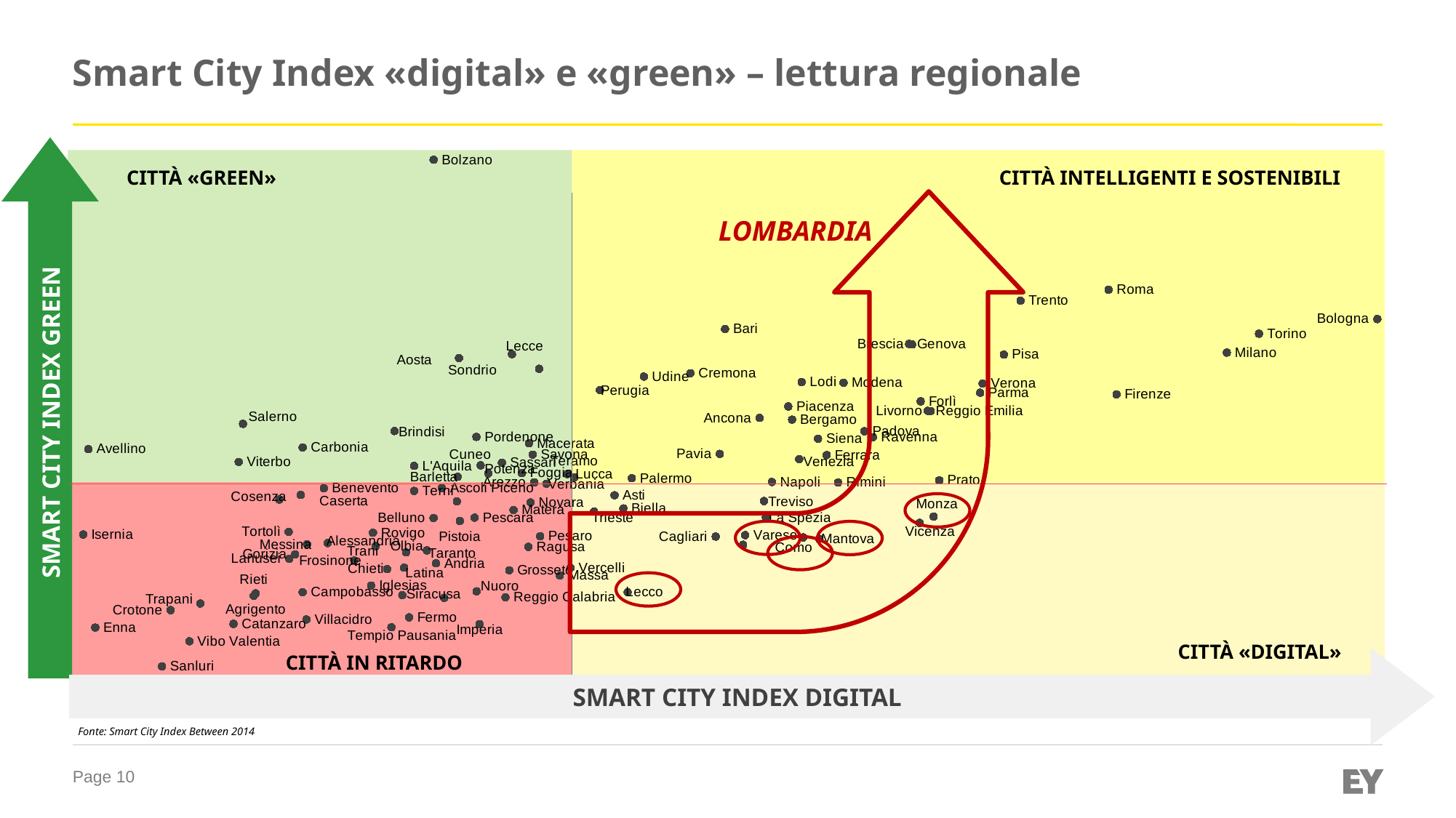
What is the label of the horizontal axis of the chart? SMART CITY INDEX DIGITAL Which city has the higher Smart City Index Digital value, Roma or Bologna? Bologna Which city has the higher Smart City Index Green value, Trento or Lecco? Trento In which quadrant of the chart is Milano located? Città intelligenti e sostenibili What kind of chart is shown on the slide? Scatter plot Which city has the higher Smart City Index Green value, Bolzano or Sanluri? Bolzano What is the label of the vertical axis of the chart? SMART CITY INDEX GREEN In which quadrant of the chart is Bolzano located? Città «green» Which city has the highest Smart City Index Green value in the chart? Bolzano How many quadrants is the chart divided into? 4 Which city has the highest Smart City Index Digital value in the chart? Bologna Which city has the lowest Smart City Index Green value in the chart? Sanluri